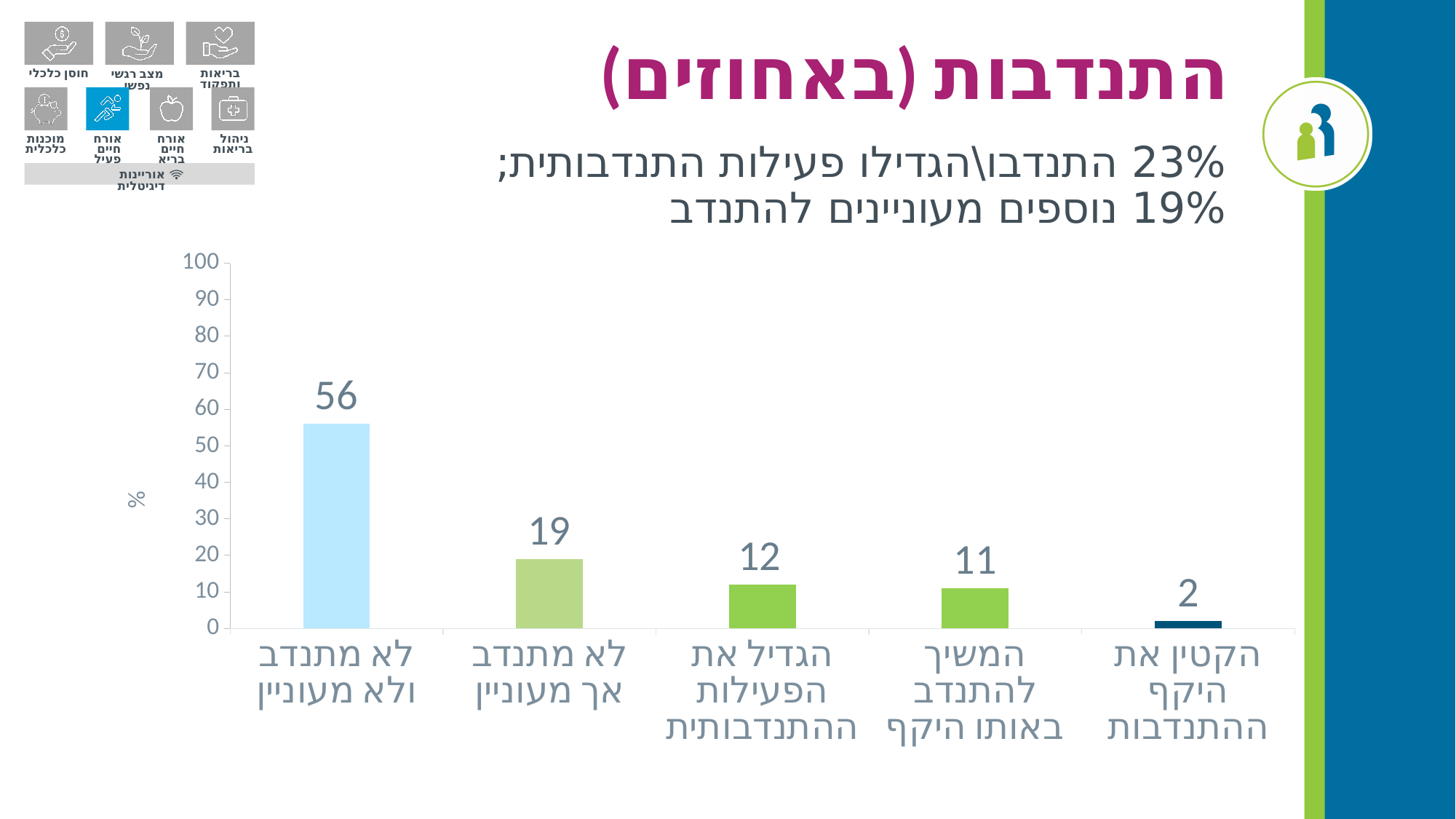
What is the title of the slide? התנדבות (באחוזים) Which category has the highest value? לא מתנדב ולא מעוניין What kind of chart is shown on the slide? bar chart What is the value for "הקטין את היקף ההתנדבות"? 2 What is the value for "הגדיל את הפעילות ההתנדבותית"? 12 What is the value for "לא מתנדב אך מעוניין"? 19 Which is larger: the value for "הגדיל את הפעילות ההתנדבותית" or "המשיך להתנדב באותו היקף"? הגדיל את הפעילות ההתנדבותית How many categories are shown in the chart? 5 Is the value for "לא מתנדב ולא מעוניין" greater or less than 50? greater What is the value for "לא מתנדב ולא מעוניין"? 56 What is the difference between the values for "לא מתנדב ולא מעוניין" and "לא מתנדב אך מעוניין"? 37 Which category has the lowest value? הקטין את היקף ההתנדבות